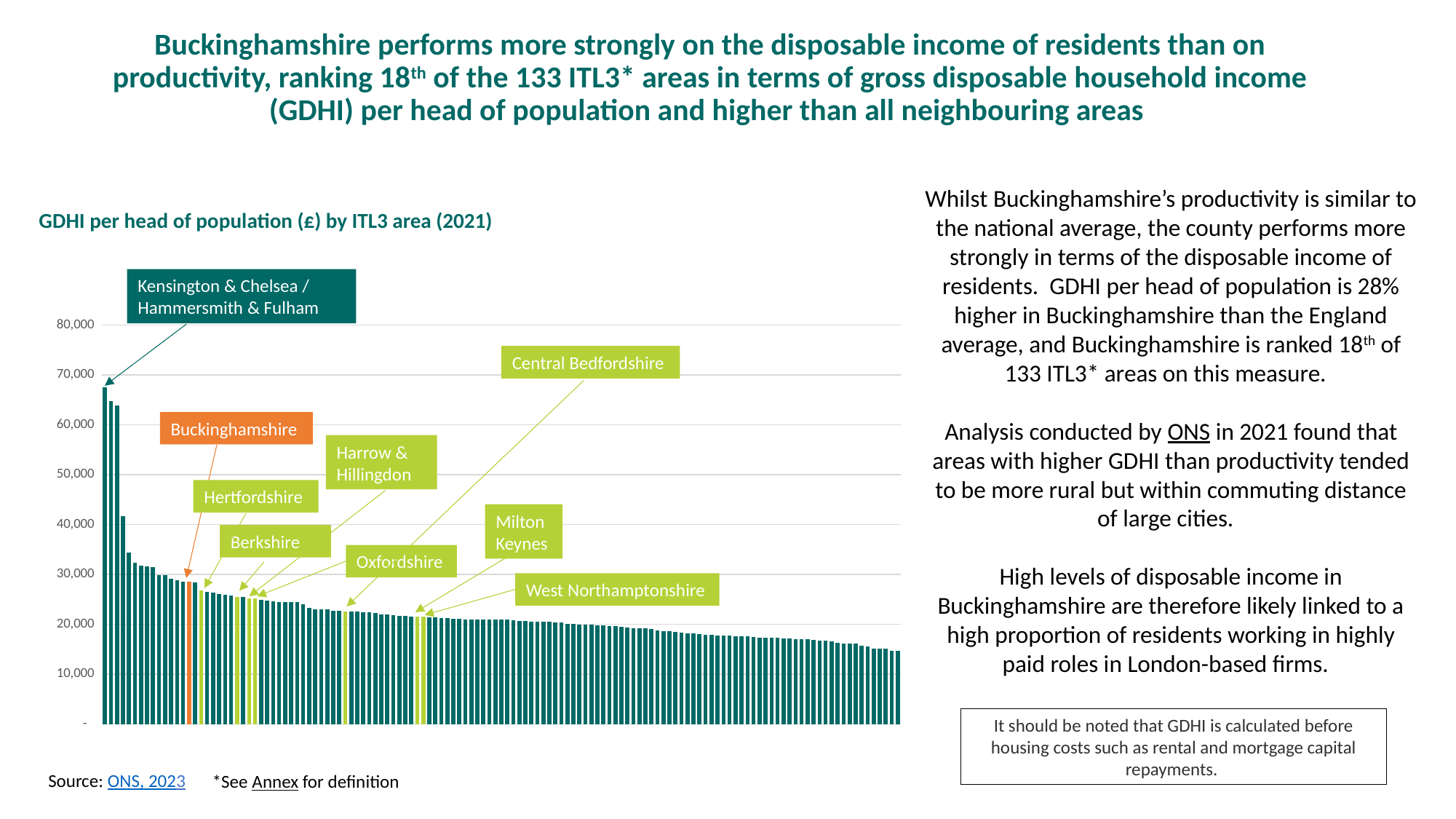
What kind of chart is shown on the slide? Bar chart Is the value for Buckinghamshire greater or less than 20,000? greater Do the bar values rise or fall from left to right across the chart? Fall Is the value for Oxfordshire greater or less than 30,000? less Which has the higher GDHI per head: Buckinghamshire or Hertfordshire? Buckinghamshire What is the title of the chart? GDHI per head of population (£) by ITL3 area (2021) How many ITL3 areas are plotted in the chart? 133 What colour is the bar for Buckinghamshire? Orange Which has the higher GDHI per head: Kensington & Chelsea / Hammersmith & Fulham or Buckinghamshire? Kensington & Chelsea / Hammersmith & Fulham Is the value for Kensington & Chelsea / Hammersmith & Fulham greater or less than 60,000? greater